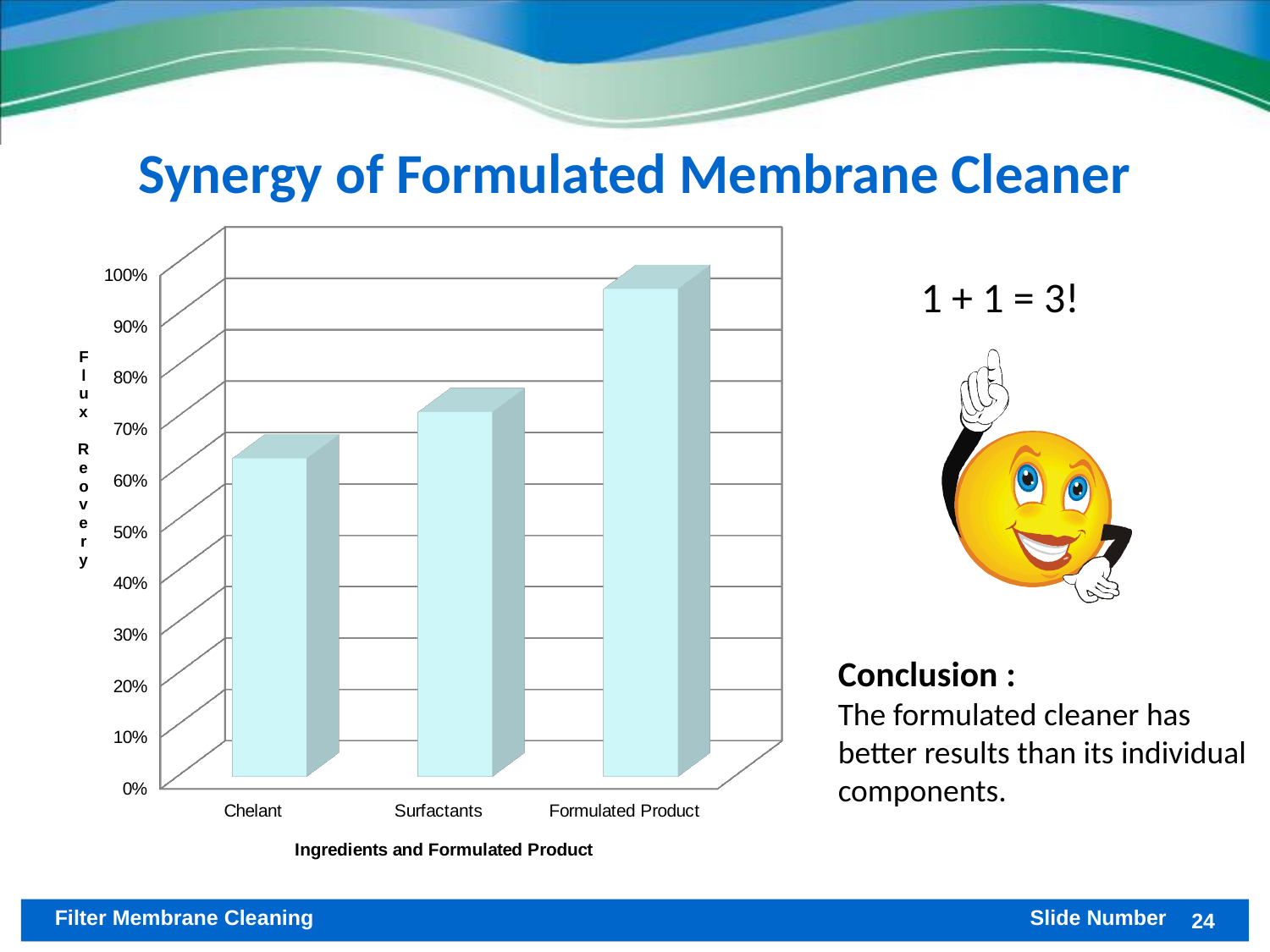
Is the value for Chelant greater or less than 70%? less Which category has the highest flux recovery? Formulated Product What is the title of the slide containing the chart? Synergy of Formulated Membrane Cleaner Which has a higher flux recovery, Chelant or Surfactants? Surfactants Is the value for Formulated Product greater or less than 90%? greater How many categories are plotted on the x axis of the chart? 3 What type of chart is shown on the slide? Bar chart What is the title of the x axis of the chart? Ingredients and Formulated Product Which has a higher flux recovery, Surfactants or Formulated Product? Formulated Product Which category has the lowest flux recovery? Chelant Is the value for Surfactants greater or less than 80%? less Do the values rise or fall moving from Chelant to Formulated Product along the x axis? Rise